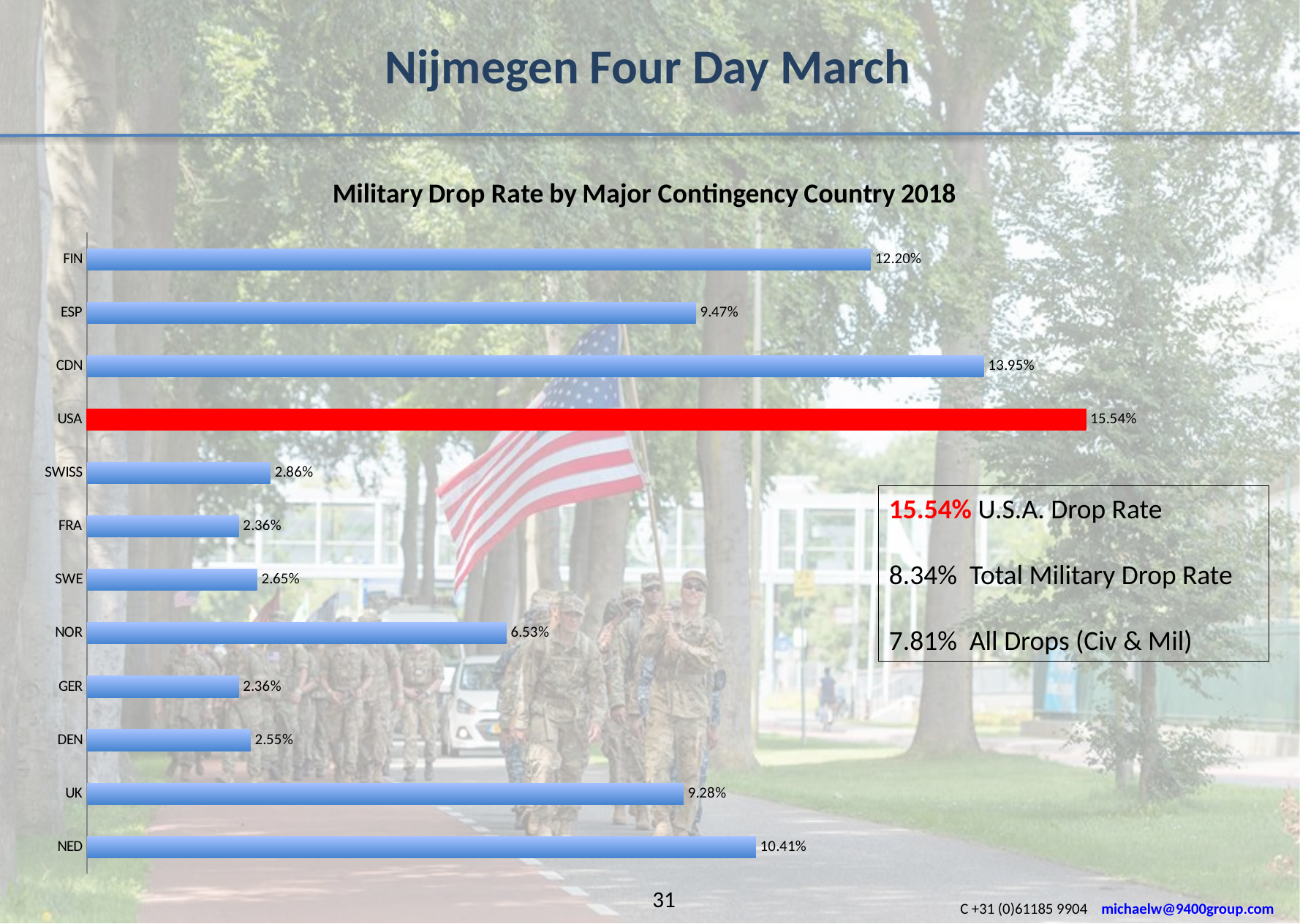
What is the military drop rate for NOR? 6.53% Which country's bar is coloured red? USA How many countries are shown in the chart? 12 What is the difference between the NED and UK drop rates? 1.13% Which has a higher drop rate, CDN or FIN? CDN What is the difference between the USA and CDN drop rates? 1.59% What is the military drop rate for NED? 10.41% Which country has the highest military drop rate? USA What is the military drop rate for CDN? 13.95% Which has a higher drop rate, NOR or SWISS? NOR What kind of chart is shown on the slide? Bar chart What is the military drop rate for SWISS? 2.86%